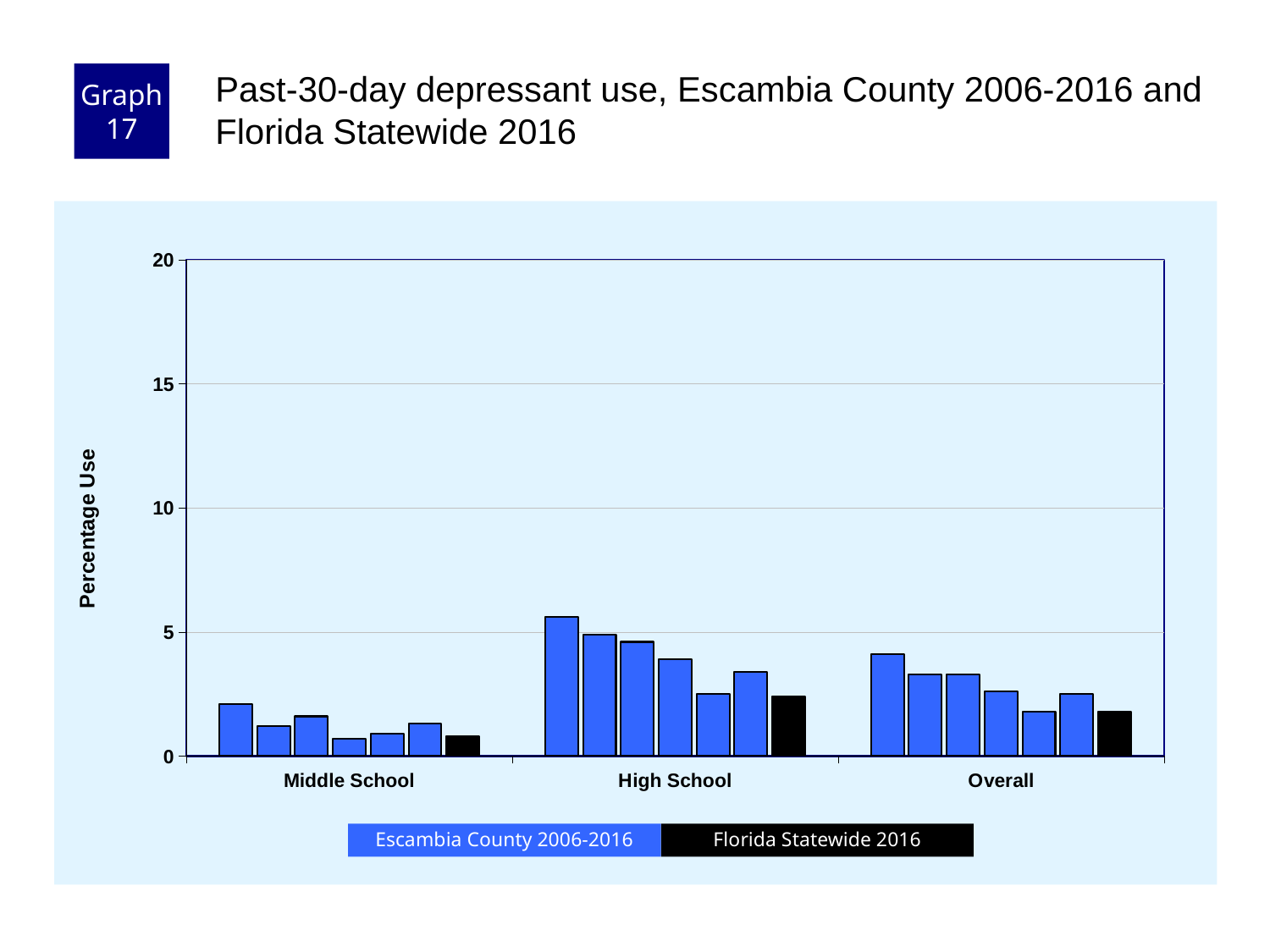
What is the label on the y axis? Percentage Use Is the value for the first Escambia County bar in High School greater or less than 5? greater Is the value for the first Escambia County bar in Overall greater or less than 5? less Which is larger, the Florida Statewide 2016 bar for High School or the Florida Statewide 2016 bar for Middle School? High School Which category has the shortest bars overall? Middle School Are any bars on the chart greater than 10? No What kind of chart is shown on the slide? bar chart How many series does the legend list? 2 How many categories are shown on the x axis? 3 Which category has the tallest bar overall? High School What colour represents Florida Statewide 2016 in the legend? black